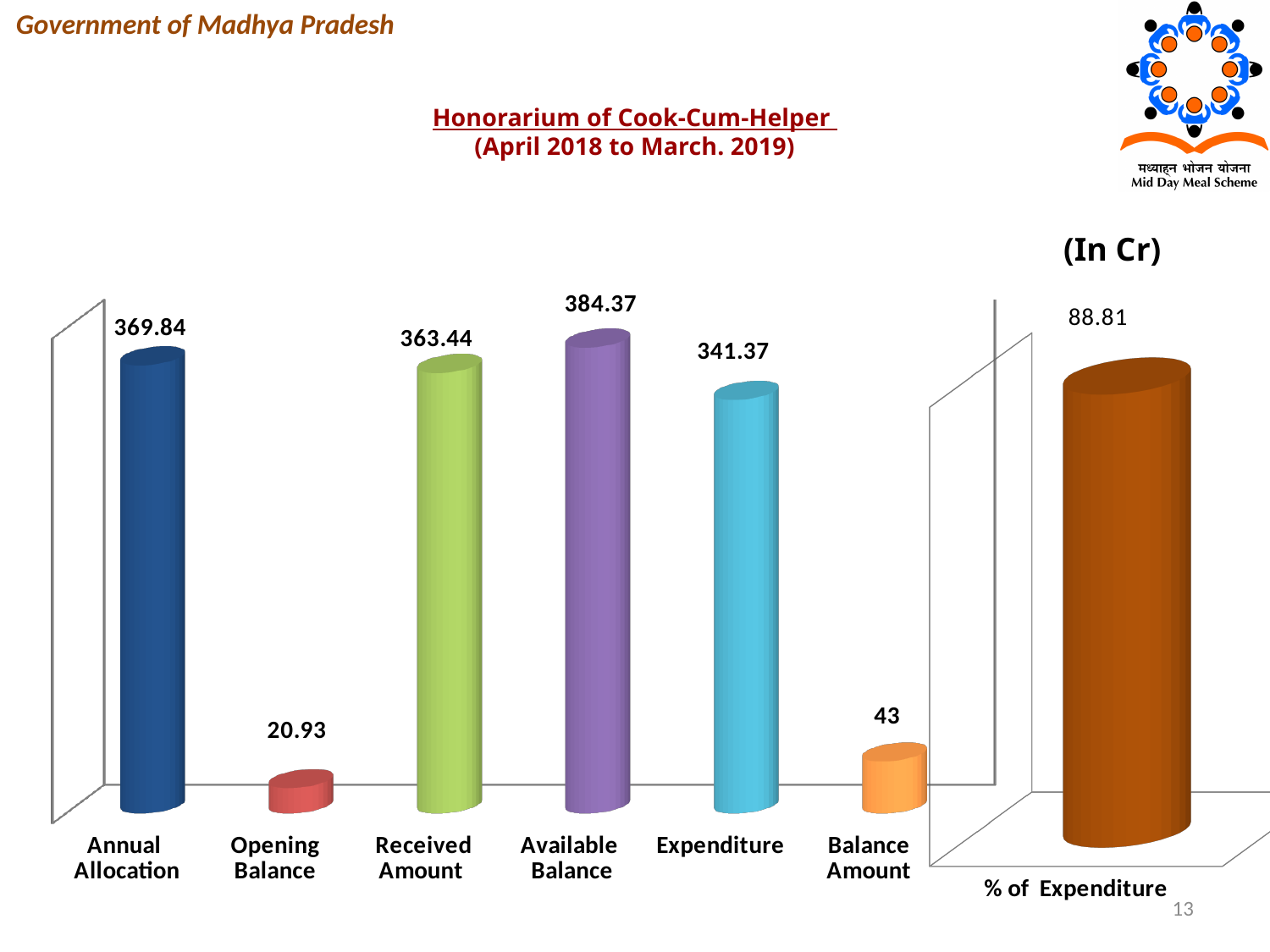
In the left chart, what is the value for Opening Balance? 20.93 In the left chart, what is the value for Expenditure? 341.37 In the left chart, which is larger, Annual Allocation or Received Amount? Annual Allocation What kind of chart is the left chart? Bar chart In the left chart, what is the value for Balance Amount? 43 In the left chart, which category has the highest value? Available Balance In the right chart, what is the value for % of Expenditure? 88.81 In the left chart, what is the value for Annual Allocation? 369.84 In the left chart, what is the difference between Available Balance and Expenditure? 43 In the left chart, which category has the lowest value? Opening Balance How many categories are shown in the left chart? 6 What unit is indicated for the values on the slide? In Cr